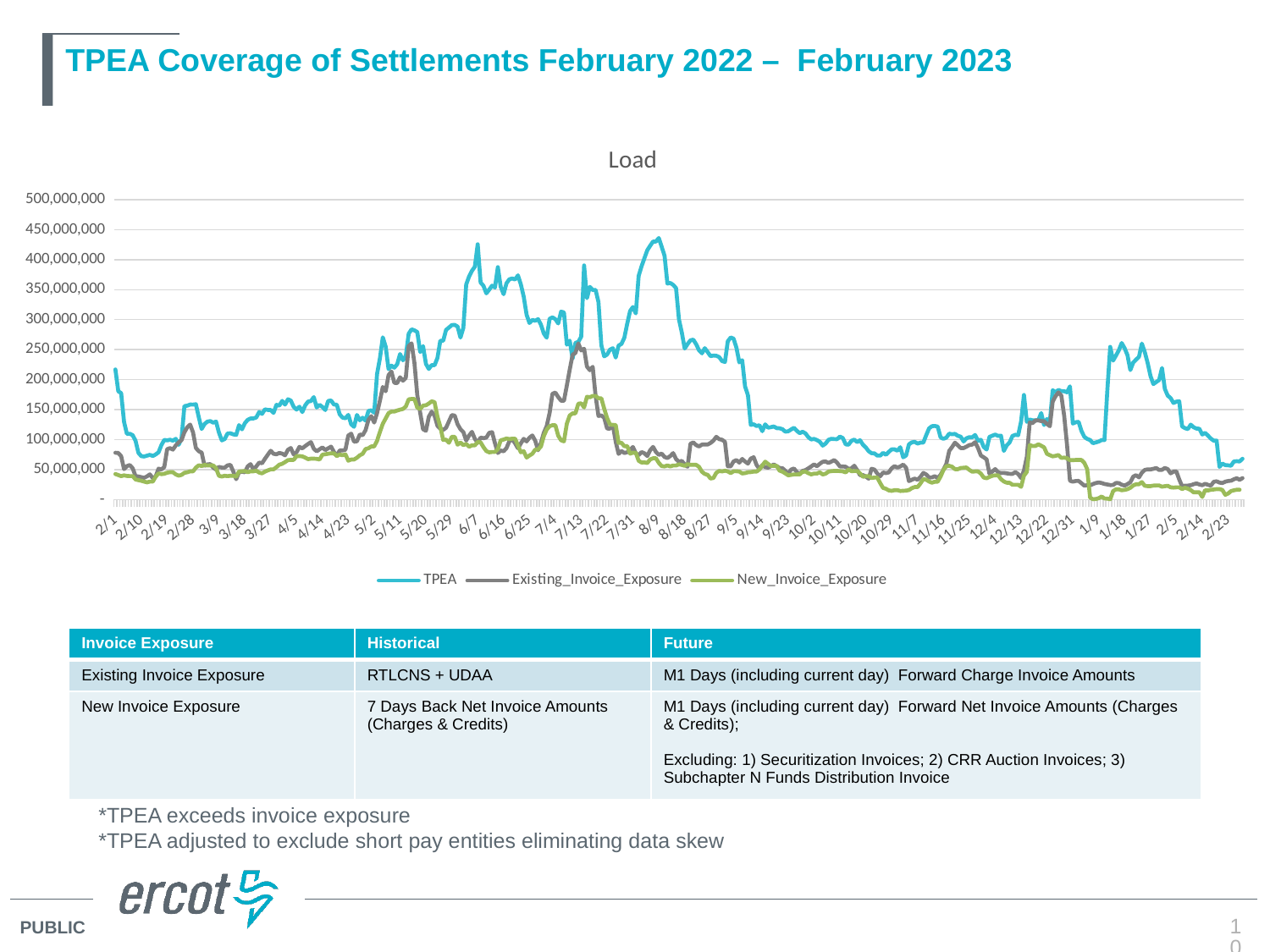
What is the title of the chart? Load Is the peak of the Existing_Invoice_Exposure line greater or less than 200,000,000? greater Which series reaches the highest value anywhere on the chart? TPEA What kind of chart is shown on the slide? Line chart Is the peak of the Existing_Invoice_Exposure line greater or less than 300,000,000? less How many series does the chart's legend list? 3 Does the TPEA line rise or fall between 8/9 and 9/14? fall What are the three series named in the chart legend? TPEA, Existing_Invoice_Exposure, New_Invoice_Exposure Is the peak value of the TPEA line greater or less than 400,000,000? greater Around 8/9, which is larger: the TPEA value or the New_Invoice_Exposure value? TPEA What is the highest value shown on the vertical axis? 500,000,000